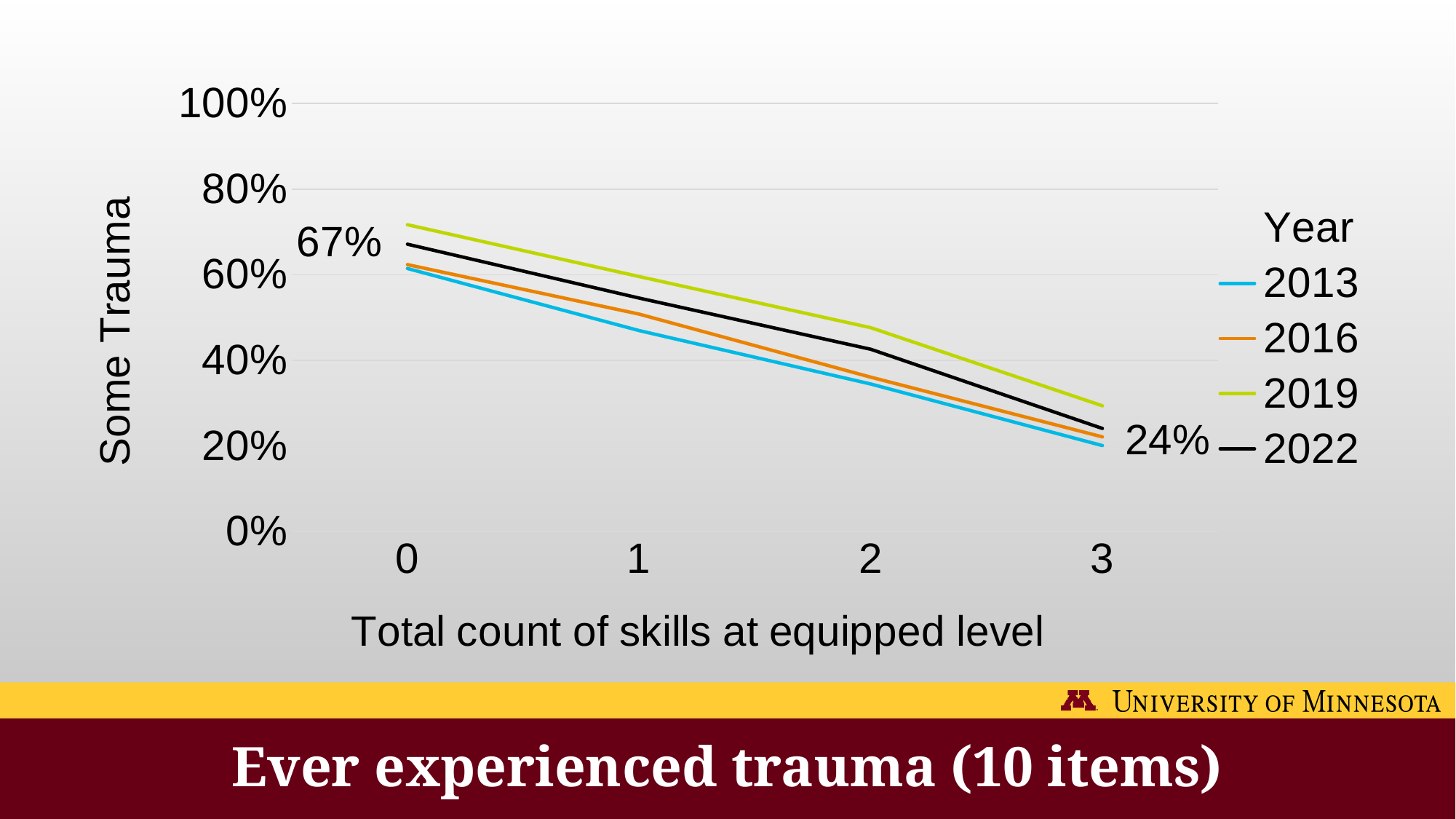
Is the value for 2019 at 0 skills greater or less than 60%? greater What is the difference between the 2022 value at 0 skills and the 2022 value at 3 skills? 43 percentage points Do the values rise or fall as the total count of skills at equipped level increases? fall Which year has the lowest value at 3 skills at equipped level? 2013 What is the value for 2022 at 3 skills at equipped level? 24% How many series does the legend list? 4 What is the value for 2022 at 0 skills at equipped level? 67% What is the title of the legend? Year Which year has the highest value at 0 skills at equipped level? 2019 What kind of chart is shown on the slide? line chart How many points are on the x axis (Total count of skills at equipped level)? 4 Is the value for 2013 at 3 skills greater or less than 40%? less